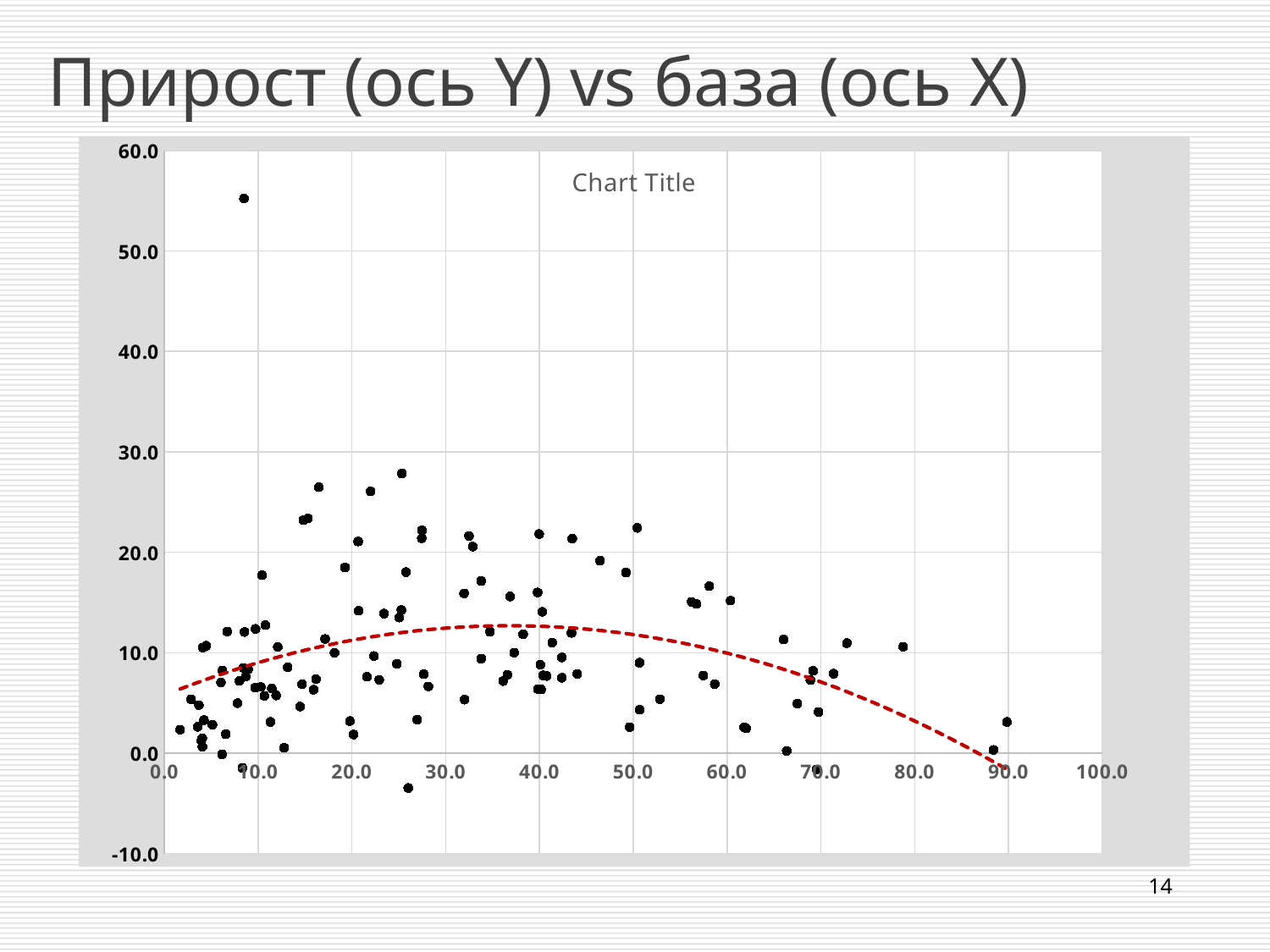
What kind of chart is shown on the slide? scatter chart What is the title printed inside the chart area? Chart Title Does the dashed trend line rise or fall as x moves from 0 to 30? rise Is the y value of the highest plotted point greater or less than 60? less Is the y value of the dashed trend line at x = 40 greater or less than 20? less Does the dashed trend line rise or fall as x moves from 60 to 90? fall Is the y value of the highest plotted point greater or less than 50? greater What is the highest value shown on the y axis? 60.0